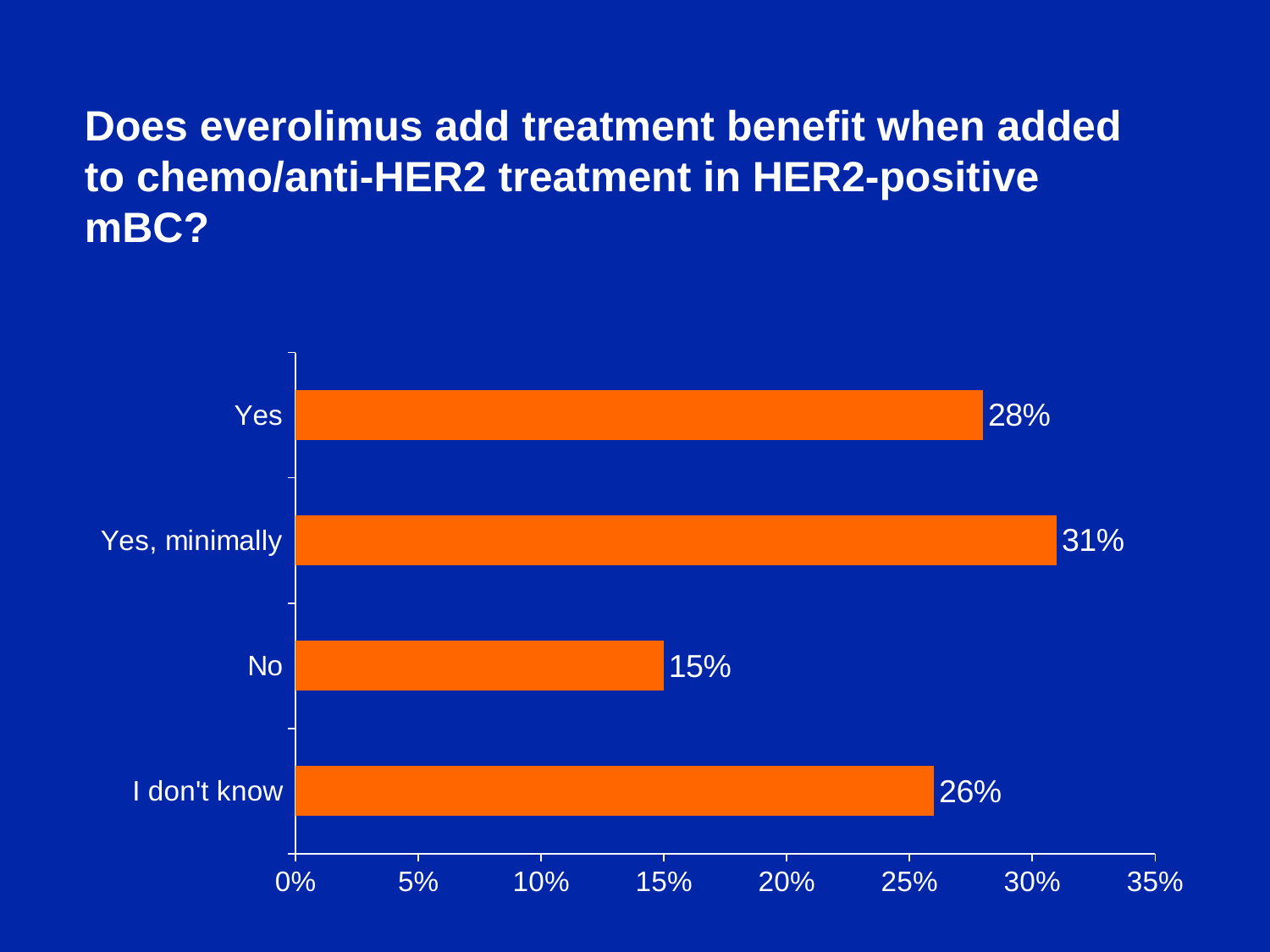
Which response category has the lowest percentage? No What kind of chart is shown on the slide? Bar chart How many response categories are shown in the chart? 4 What percentage of respondents answered "Yes, minimally"? 31% Which is larger, the value for "Yes" or the value for "I don't know"? Yes What is the maximum value shown on the horizontal axis? 35% Which response category has the highest percentage? Yes, minimally What percentage of respondents answered "Yes"? 28% What percentage of respondents answered "I don't know"? 26% What is the difference in percentage points between "Yes, minimally" and "No"? 16% What percentage of respondents answered "No"? 15% What is the difference in percentage points between "Yes" and "I don't know"? 2%